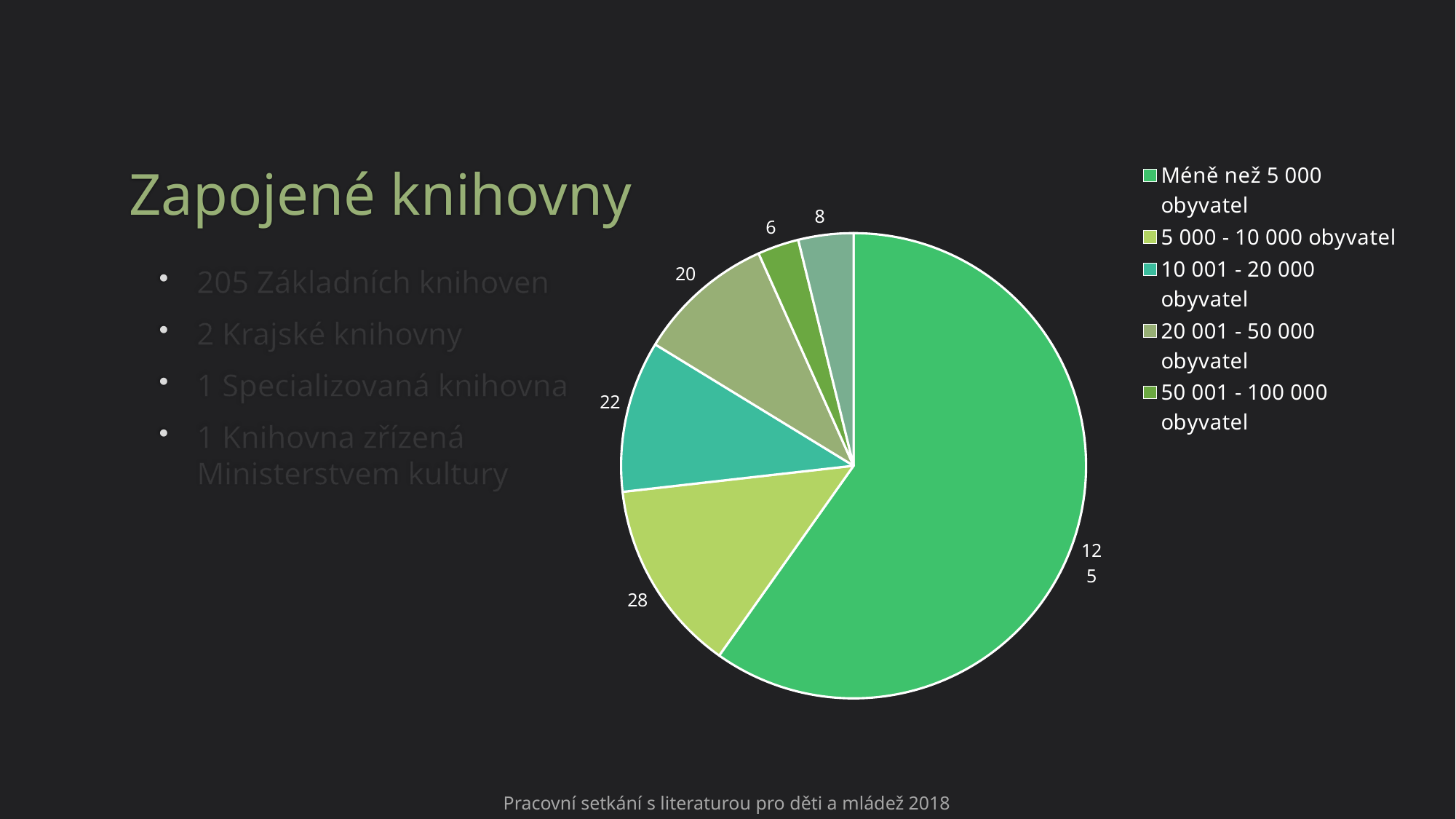
What value is shown for the '10 001 - 20 000 obyvatel' slice? 22 What value is shown for the 'Méně než 5 000 obyvatel' slice of the pie chart? 125 What value is shown for the '5 000 - 10 000 obyvatel' slice? 28 What type of chart is shown on the slide? Pie chart How many slices does the pie chart have? 6 What is the difference between the 'Méně než 5 000 obyvatel' slice and the '5 000 - 10 000 obyvatel' slice? 97 Which legend category has the smallest slice in the pie chart? 50 001 - 100 000 obyvatel Which is larger: the '10 001 - 20 000 obyvatel' slice or the '20 001 - 50 000 obyvatel' slice? 10 001 - 20 000 obyvatel What value is shown for the '50 001 - 100 000 obyvatel' slice? 6 Which category has the largest slice in the pie chart? Méně než 5 000 obyvatel What value is shown for the '20 001 - 50 000 obyvatel' slice? 20 How many entries does the legend of the pie chart list? 5